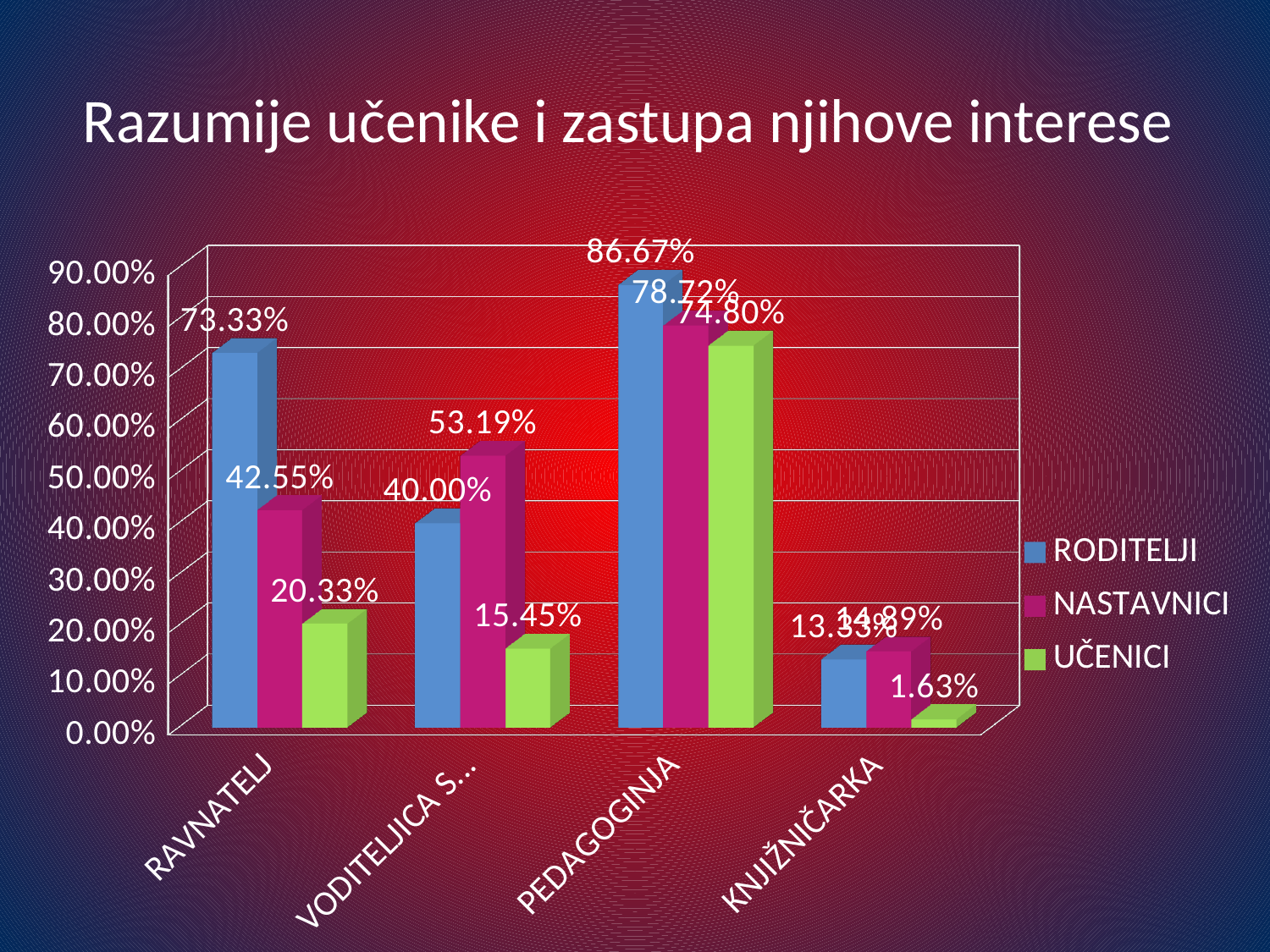
Which category has the lowest UČENICI value? KNJIŽNIČARKA How many categories are shown on the x axis? 4 What is the RODITELJI value for RAVNATELJ? 73.33% Which category has the highest RODITELJI value? PEDAGOGINJA What is the UČENICI value for KNJIŽNIČARKA? 1.63% For PEDAGOGINJA, which is larger: the RODITELJI value or the UČENICI value? RODITELJI Which series is shown in green? UČENICI What is the NASTAVNICI value for PEDAGOGINJA? 78.72% What is the title of the chart? Razumije učenike i zastupa njihove interese How many series does the legend list? 3 What type of chart is shown on the slide? bar chart What is the difference between the RODITELJI and UČENICI values for RAVNATELJ? 53.00%